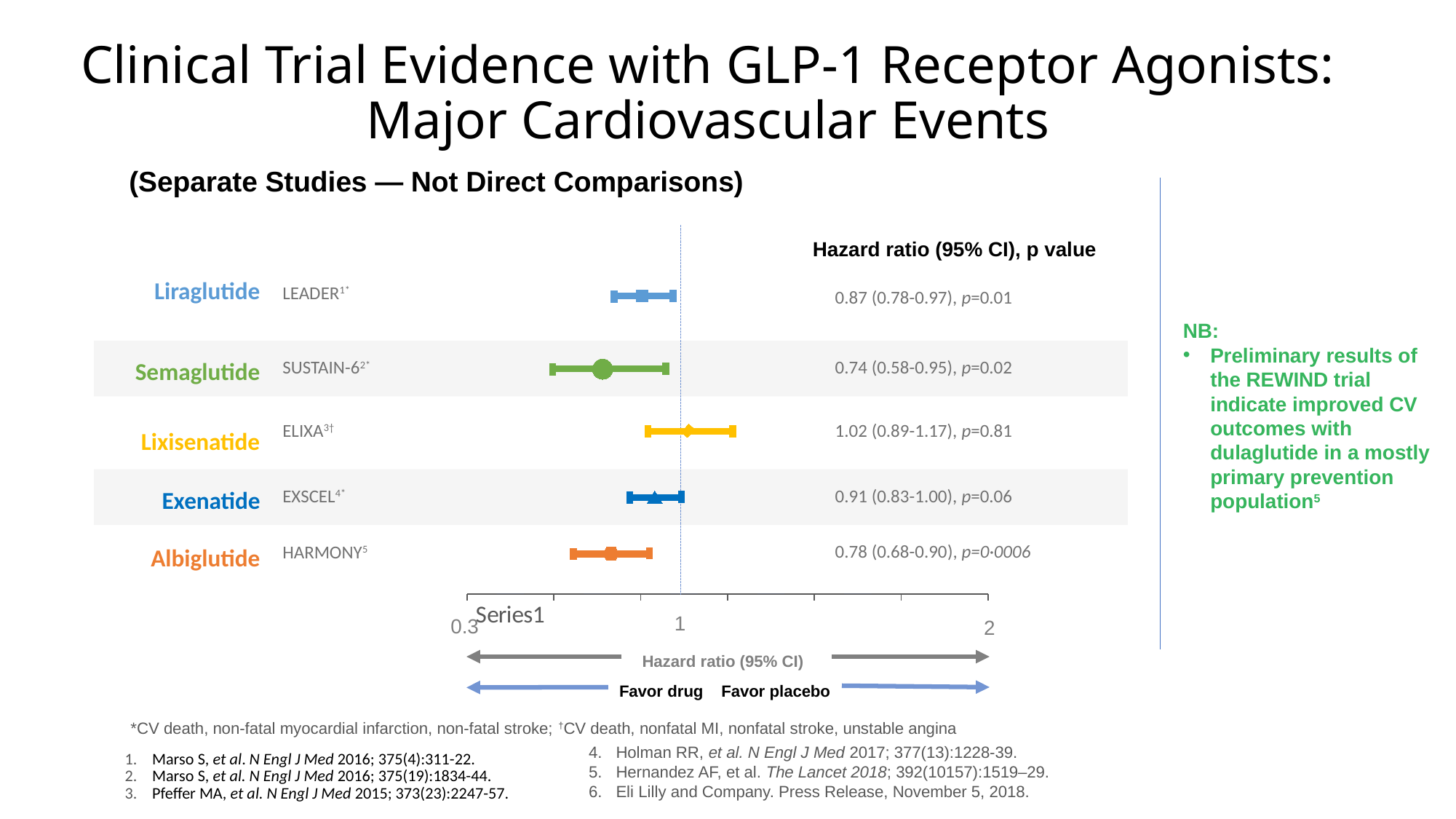
What is the 95% confidence interval for the hazard ratio in the SUSTAIN-6 trial (semaglutide)? 0.58-0.95 How many trials are plotted on the chart? 5 What kind of chart is shown on the slide? Forest plot Which has the larger hazard ratio, EXSCEL or LEADER? EXSCEL Which trial has the highest hazard ratio? ELIXA What does the left side of the x axis (below 1) favor, according to the label under the chart? Favor drug What is the hazard ratio for the LEADER trial (liraglutide)? 0.87 Which trial has the lowest hazard ratio? SUSTAIN-6 What is the difference between the hazard ratios of ELIXA and SUSTAIN-6? 0.28 Is the hazard ratio for ELIXA greater or less than 1? greater What is the hazard ratio for the HARMONY trial (albiglutide)? 0.78 What is the p value for the ELIXA trial (lixisenatide)? p=0.81